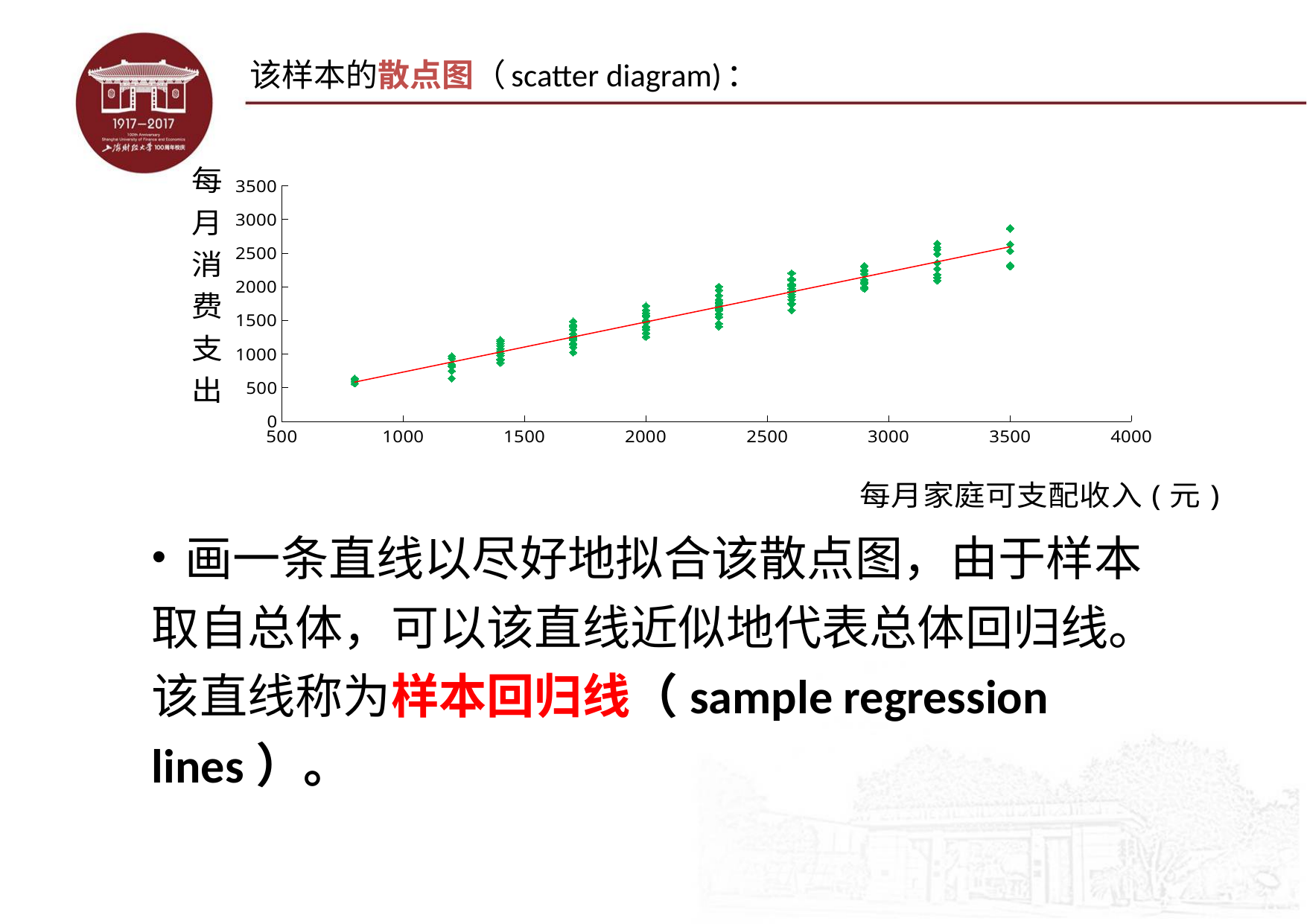
Are the consumption values for the points at income 1400 greater or less than 1500? less What is the highest tick value shown on the y axis? 3500 Which income level has the highest plotted consumption values, 800 or 3500? 3500 Are the consumption values for the points at income 3500 greater or less than 2000? greater What is the label of the x axis? 每月家庭可支配收入（元） Do the plotted consumption values rise or fall as monthly household disposable income increases along the x axis? rise At which income level are the lowest consumption values plotted? 800 Are the consumption values for the points at income 800 greater or less than 1000? less What kind of chart is shown on the slide? scatter chart How many distinct income levels (clusters of points) are plotted along the x axis? 10